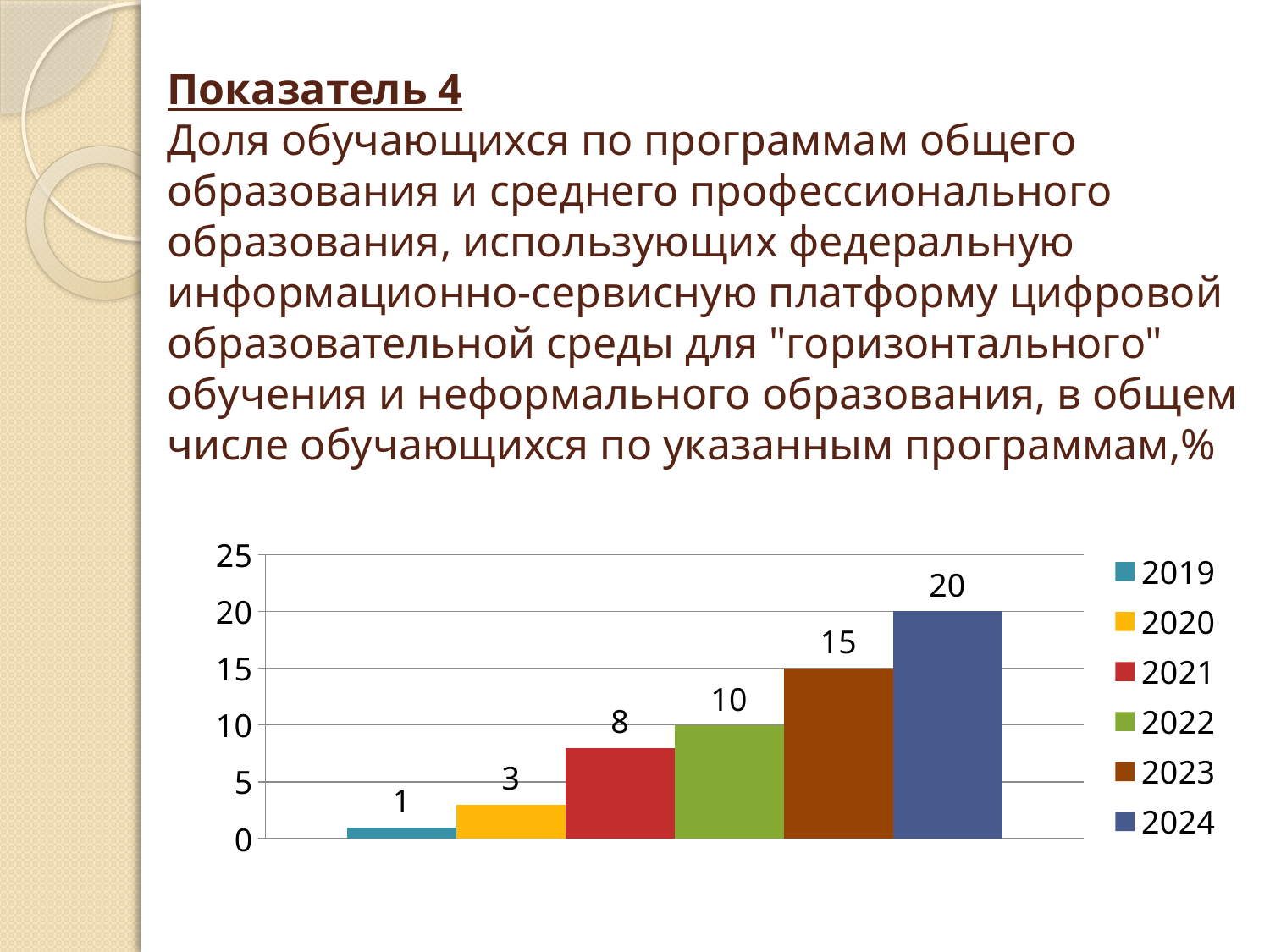
What kind of chart is shown on the slide? bar chart What is the value for 2024? 20 Which is larger, the value for 2022 or the value for 2021? 2022 What is the value for 2022? 10 Which year has the lowest value? 2019 How many bars are shown in the chart? 6 What is the value for 2019? 1 Which year has the highest value? 2024 What is the difference between the values for 2021 and 2020? 5 What is the difference between the values for 2024 and 2023? 5 Is the value for 2023 greater or less than 10? greater How many entries does the legend list? 6